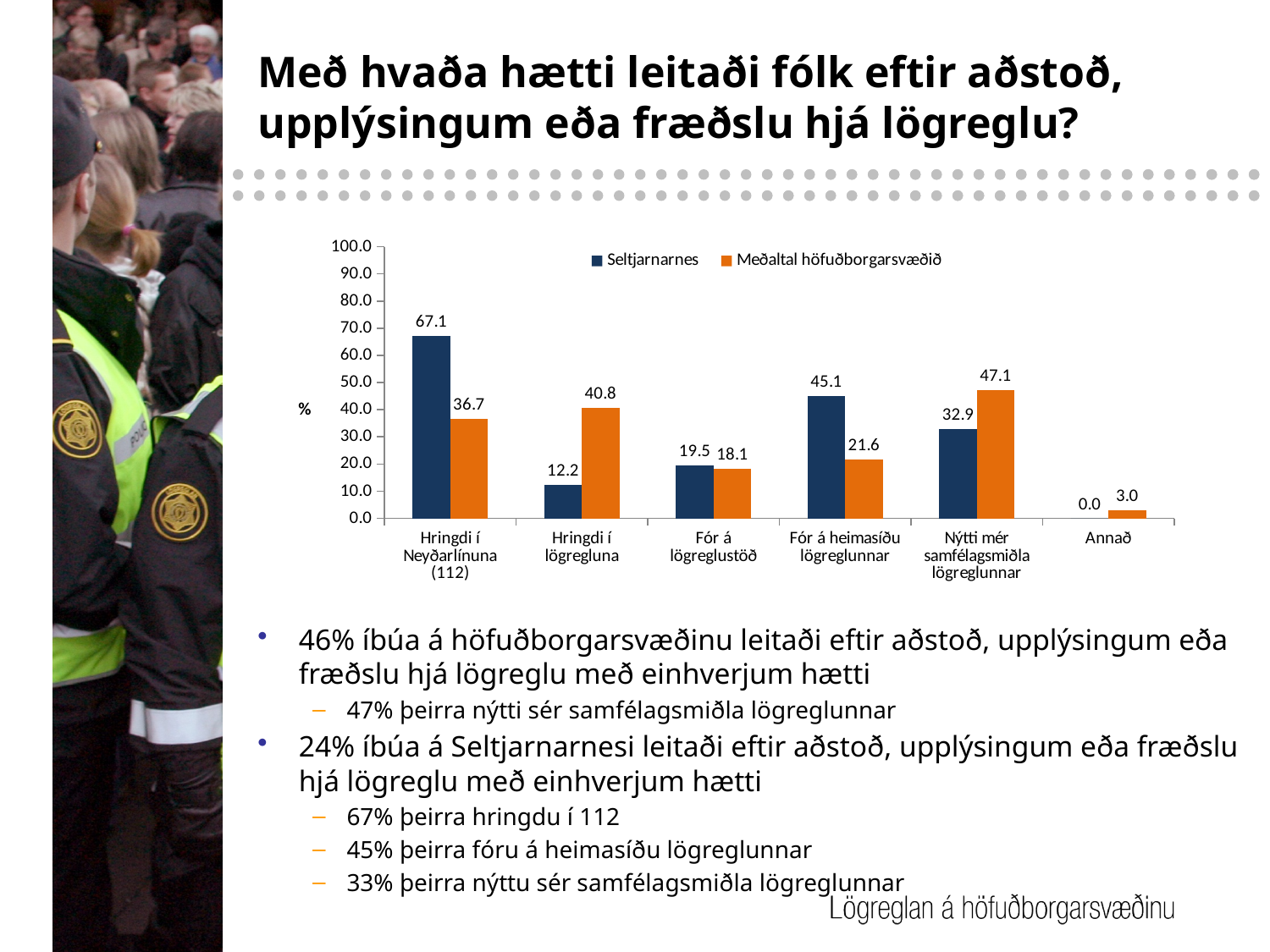
What is the value for Meðaltal höfuðborgarsvæðið in the 'Hringdi í lögregluna' category? 40.8 What is the value for Meðaltal höfuðborgarsvæðið in the 'Nýtti mér samfélagsmiðla lögreglunnar' category? 47.1 Is the Seltjarnarnes value for 'Fór á lögreglustöð' greater or less than 30.0? less In the 'Hringdi í lögregluna' category, which series has the larger value, Seltjarnarnes or Meðaltal höfuðborgarsvæðið? Meðaltal höfuðborgarsvæðið What colour are the bars for the Seltjarnarnes series? Dark blue Which category has the lowest value for Meðaltal höfuðborgarsvæðið? Annað How many categories are shown on the x axis of the chart? 6 How many series does the chart legend list? 2 What is the difference between the Seltjarnarnes and Meðaltal höfuðborgarsvæðið values in the 'Fór á heimasíðu lögreglunnar' category? 23.5 What kind of chart is shown on the slide? Bar chart What is the value for Seltjarnarnes in the 'Hringdi í Neyðarlínuna (112)' category? 67.1 Which category has the highest value for Seltjarnarnes? Hringdi í Neyðarlínuna (112)